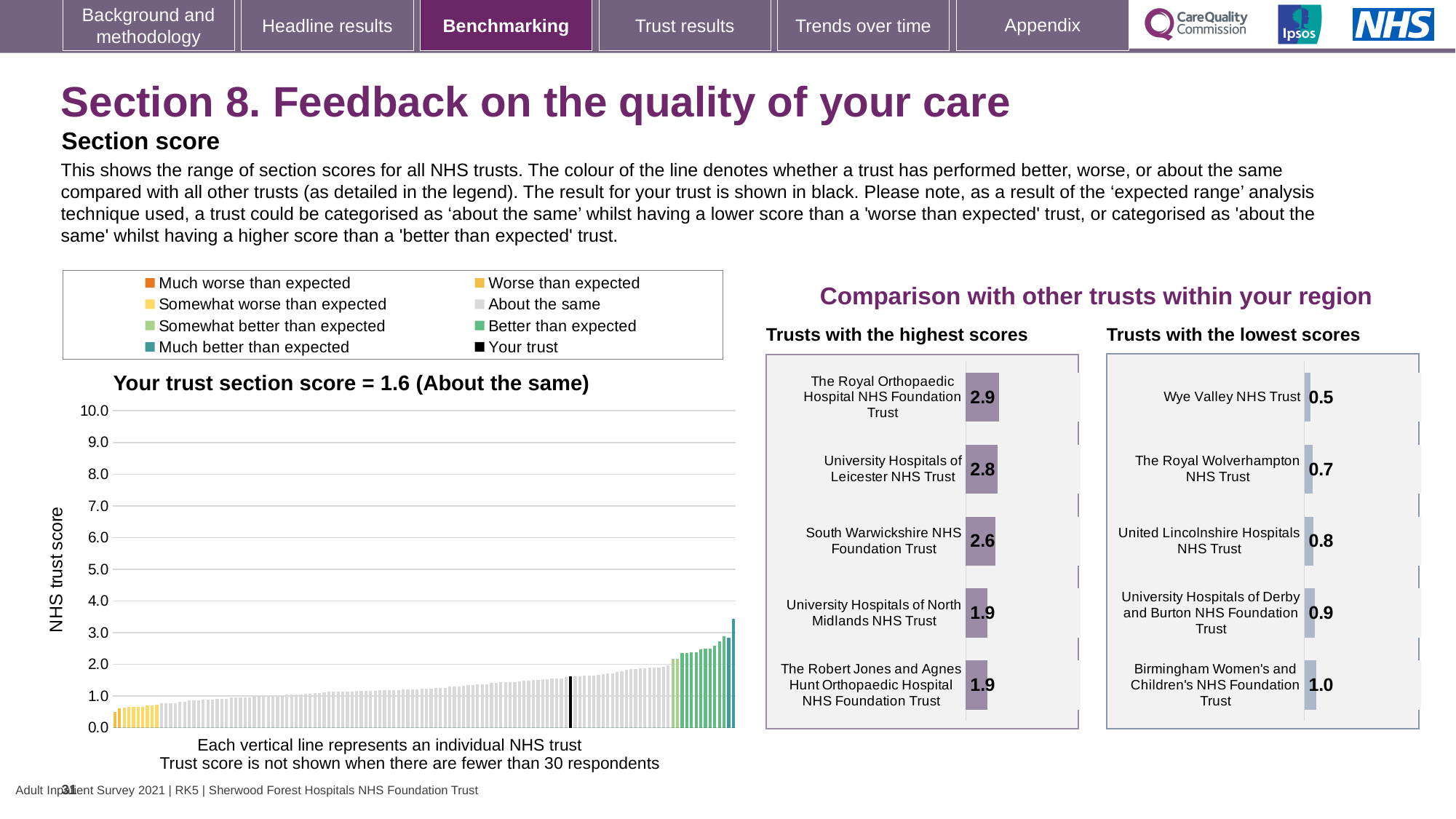
What kind of chart is the 'Your trust section score' chart? Bar chart In the 'Trusts with the lowest scores' chart, which trust has the lowest score? Wye Valley NHS Trust In the 'Trusts with the lowest scores' chart, which has the higher score: The Royal Wolverhampton NHS Trust or Birmingham Women's and Children's NHS Foundation Trust? Birmingham Women's and Children's NHS Foundation Trust In the 'Trusts with the highest scores' chart, what is the score for The Royal Orthopaedic Hospital NHS Foundation Trust? 2.9 In the 'Your trust section score' chart, is the value of the tallest bar greater or less than 3.0? greater In the 'Trusts with the lowest scores' chart, what is the score for United Lincolnshire Hospitals NHS Trust? 0.8 In the 'Trusts with the highest scores' chart, what is the score for South Warwickshire NHS Foundation Trust? 2.6 How many trusts are listed in the 'Trusts with the highest scores' chart? 5 In the 'Your trust section score' chart, do the trust scores rise or fall from left to right? Rise In the 'Your trust section score' chart, what is the section score for your trust? 1.6 In the 'Trusts with the highest scores' chart, what is the difference between the scores of University Hospitals of Leicester NHS Trust and University Hospitals of North Midlands NHS Trust? 0.9 How many entries does the legend of the 'Your trust section score' chart list? 8